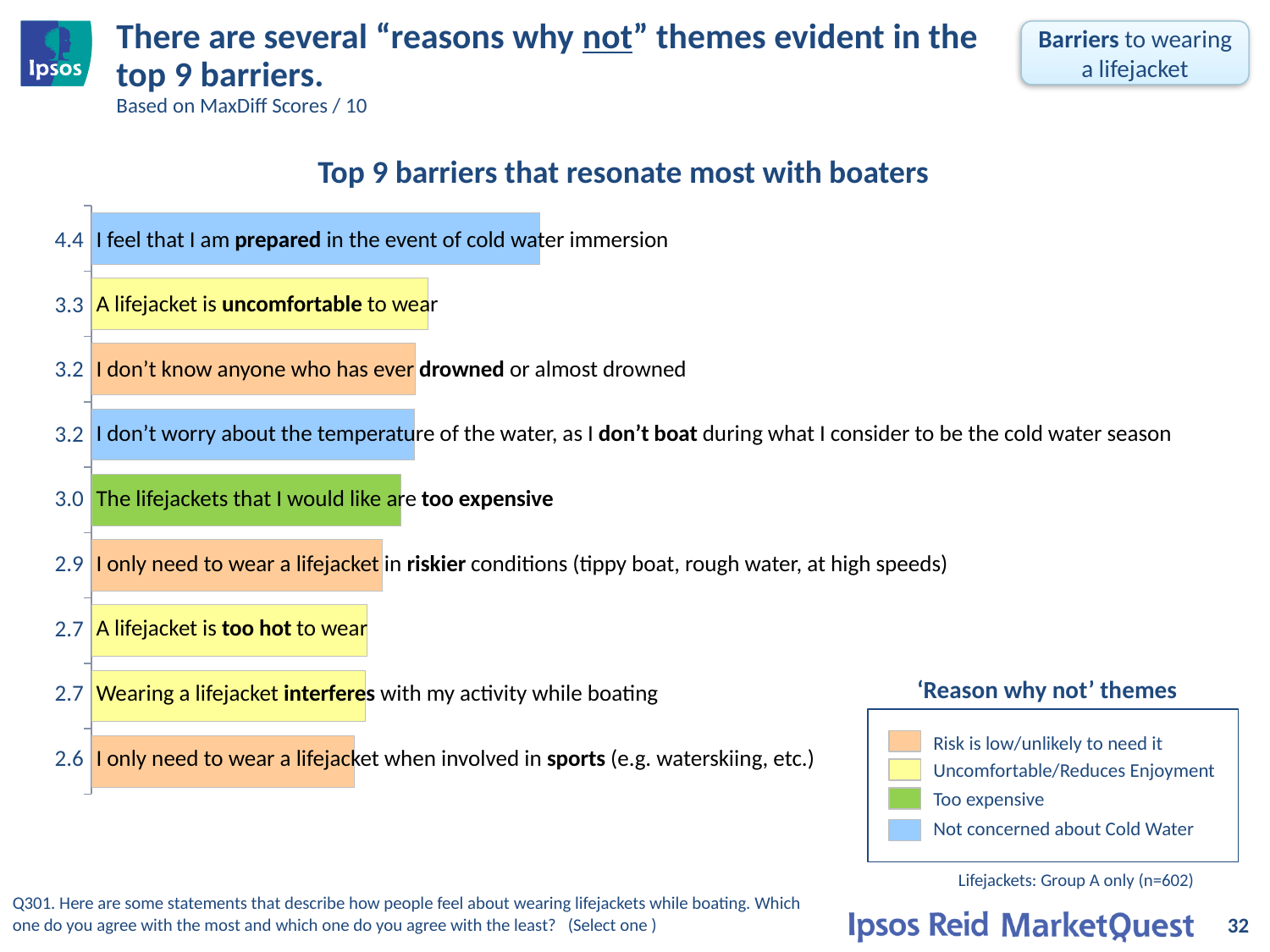
Which theme does the green colour represent in the legend? Too expensive How many barriers are shown in the chart? 9 What type of chart is shown on the slide? Bar chart How many 'Reason why not' themes does the legend list? 4 What is the MaxDiff score for "I feel that I am prepared in the event of cold water immersion"? 4.4 What is the score for "I only need to wear a lifejacket when involved in sports (e.g. waterskiing, etc.)"? 2.6 Which barrier has the lowest score? I only need to wear a lifejacket when involved in sports (e.g. waterskiing, etc.) What is the difference between the score for "I feel that I am prepared in the event of cold water immersion" and the score for "A lifejacket is uncomfortable to wear"? 1.1 What is the score for "The lifejackets that I would like are too expensive"? 3.0 Which barrier has the highest score? I feel that I am prepared in the event of cold water immersion Which has a higher score: "A lifejacket is too hot to wear" or "I only need to wear a lifejacket in riskier conditions"? I only need to wear a lifejacket in riskier conditions What is the score for "A lifejacket is uncomfortable to wear"? 3.3